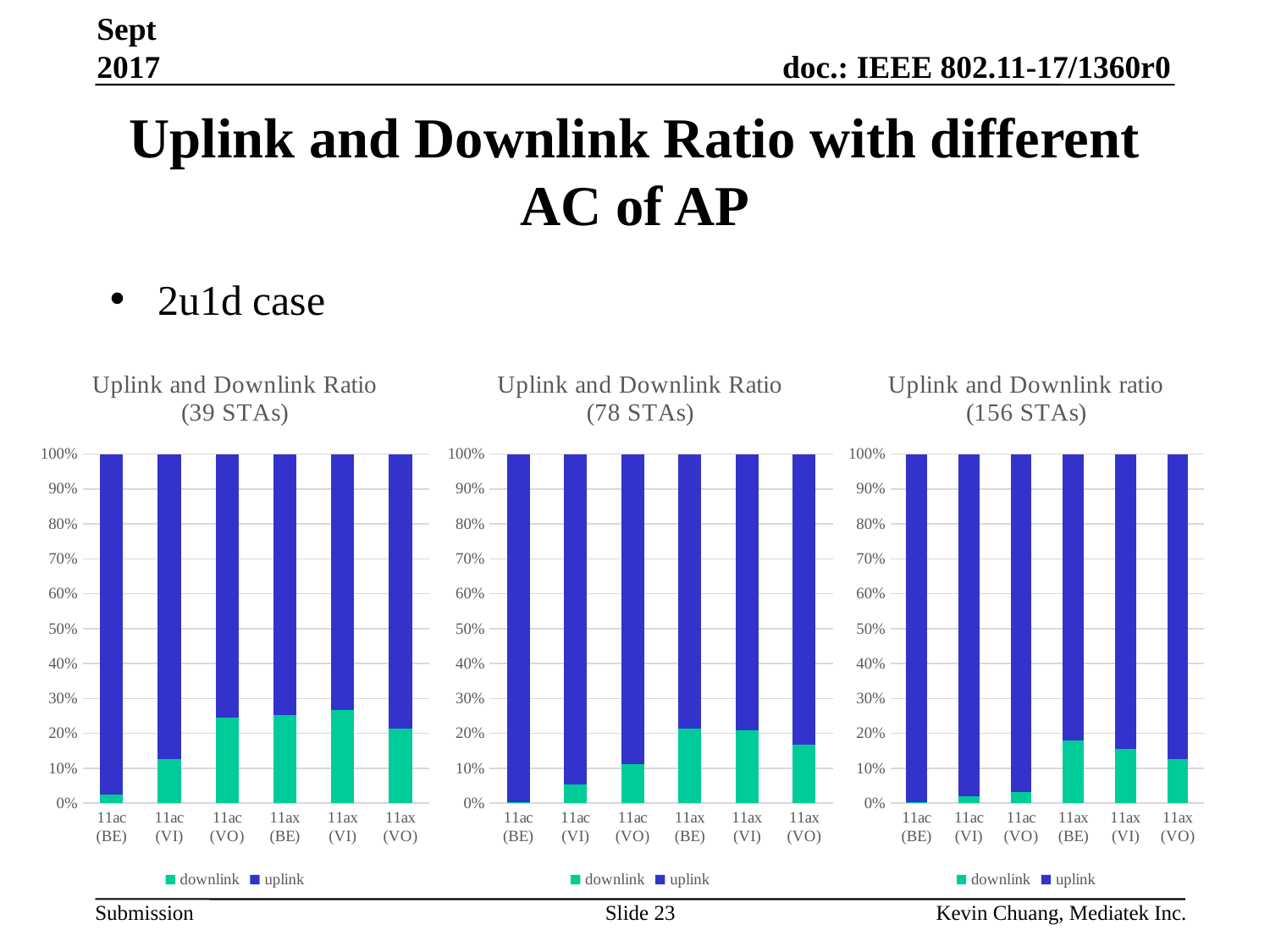
In the 'Uplink and Downlink Ratio (78 STAs)' chart, is the downlink share for 11ac (VO) greater or less than 20%? less In the 'Uplink and Downlink Ratio (78 STAs)' chart, which has the larger downlink share, 11ac (VO) or 11ax (VO)? 11ax (VO) What are the two legend entries of the 'Uplink and Downlink Ratio (78 STAs)' chart? downlink, uplink In the 'Uplink and Downlink Ratio (39 STAs)' chart, which category has the lowest downlink share? 11ac (BE) How many categories are shown on the x axis of the 'Uplink and Downlink Ratio (78 STAs)' chart? 6 How many series does the legend of the 'Uplink and Downlink ratio (156 STAs)' chart list? 2 In the 'Uplink and Downlink ratio (156 STAs)' chart, is the downlink share for 11ax (BE) greater or less than 20%? less In the 'Uplink and Downlink Ratio (39 STAs)' chart, is the downlink share for 11ac (VI) greater or less than 20%? less In the 'Uplink and Downlink ratio (156 STAs)' chart, which category has the highest downlink share? 11ax (BE) What kind of chart is the 'Uplink and Downlink Ratio (39 STAs)' chart? stacked bar chart In the 'Uplink and Downlink ratio (156 STAs)' chart, which has the larger downlink share, 11ac (VI) or 11ax (VI)? 11ax (VI) In the 'Uplink and Downlink Ratio (39 STAs)' chart, what does each stacked bar total? 100%